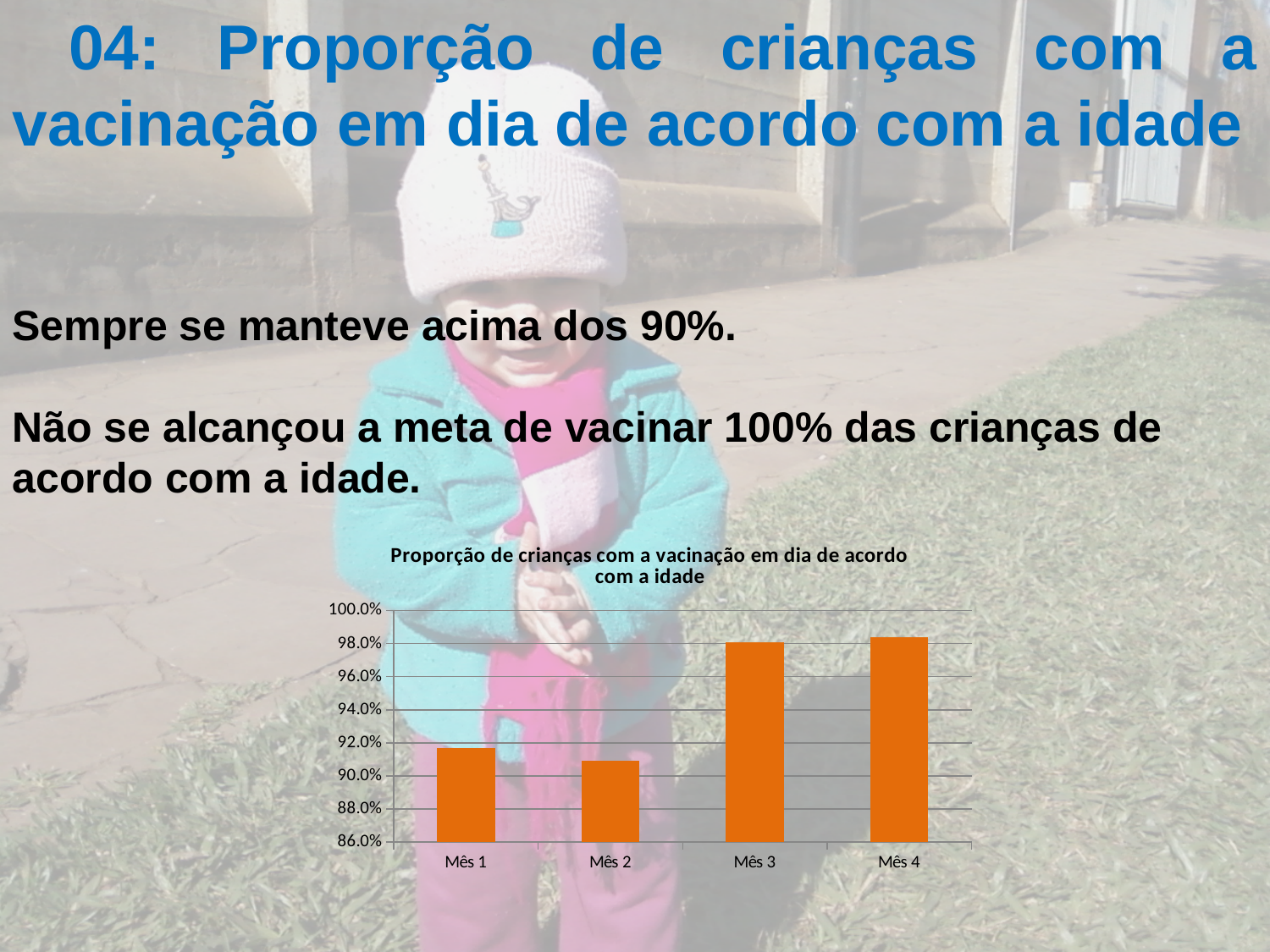
What is the title of the chart? Proporção de crianças com a vacinação em dia de acordo com a idade What is the lowest value shown on the vertical axis of the chart? 86.0% Which month has the lowest proportion of children with up-to-date vaccination? Mês 2 Which is larger, the value for Mês 1 or the value for Mês 2? Mês 1 Which is larger, the value for Mês 3 or the value for Mês 1? Mês 3 Is the value for Mês 3 greater or less than 96.0%? greater What kind of chart is shown on the slide? bar chart How many categories (months) are plotted on the chart? 4 Is the value for Mês 4 greater or less than 100.0%? less Is the value for Mês 2 greater or less than 92.0%? less